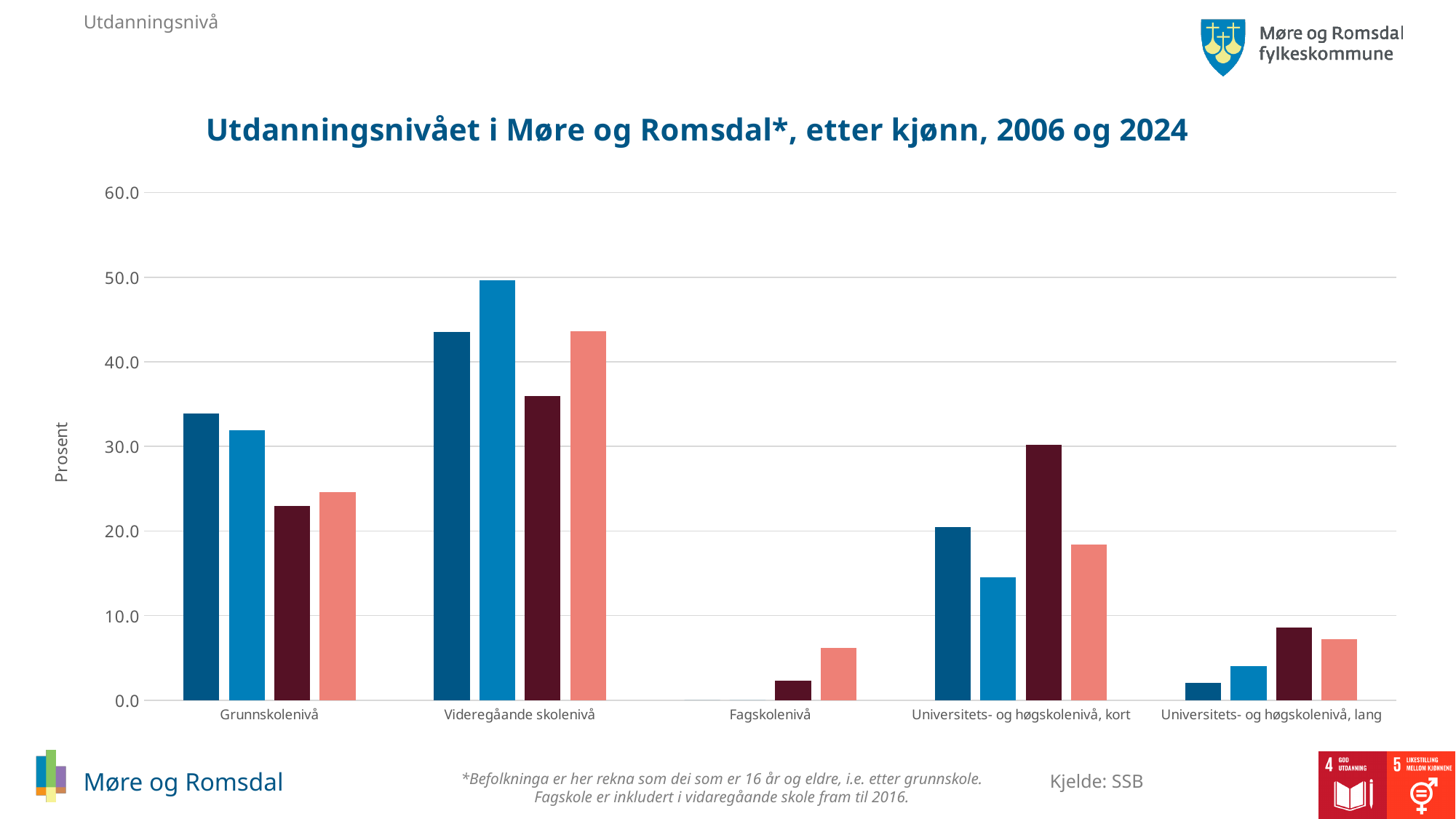
For Universitets- og høgskolenivå, kort, which is larger: the dark maroon bar or the light blue bar? the dark maroon bar Is the value of the dark blue bar for Videregåande skolenivå greater or less than 40? greater Is the value of the dark blue bar for Grunnskolenivå greater or less than 30? greater For Grunnskolenivå, which is larger: the dark blue bar or the dark maroon bar? the dark blue bar Is the value of the salmon-coloured bar for Fagskolenivå greater or less than 10? less What kind of chart is shown on the slide? bar chart Which category contains the tallest bar in the chart? Videregåande skolenivå What is the title of the chart? Utdanningsnivået i Møre og Romsdal*, etter kjønn, 2006 og 2024 What is the label on the y axis? Prosent How many education-level categories are shown on the x axis? 5